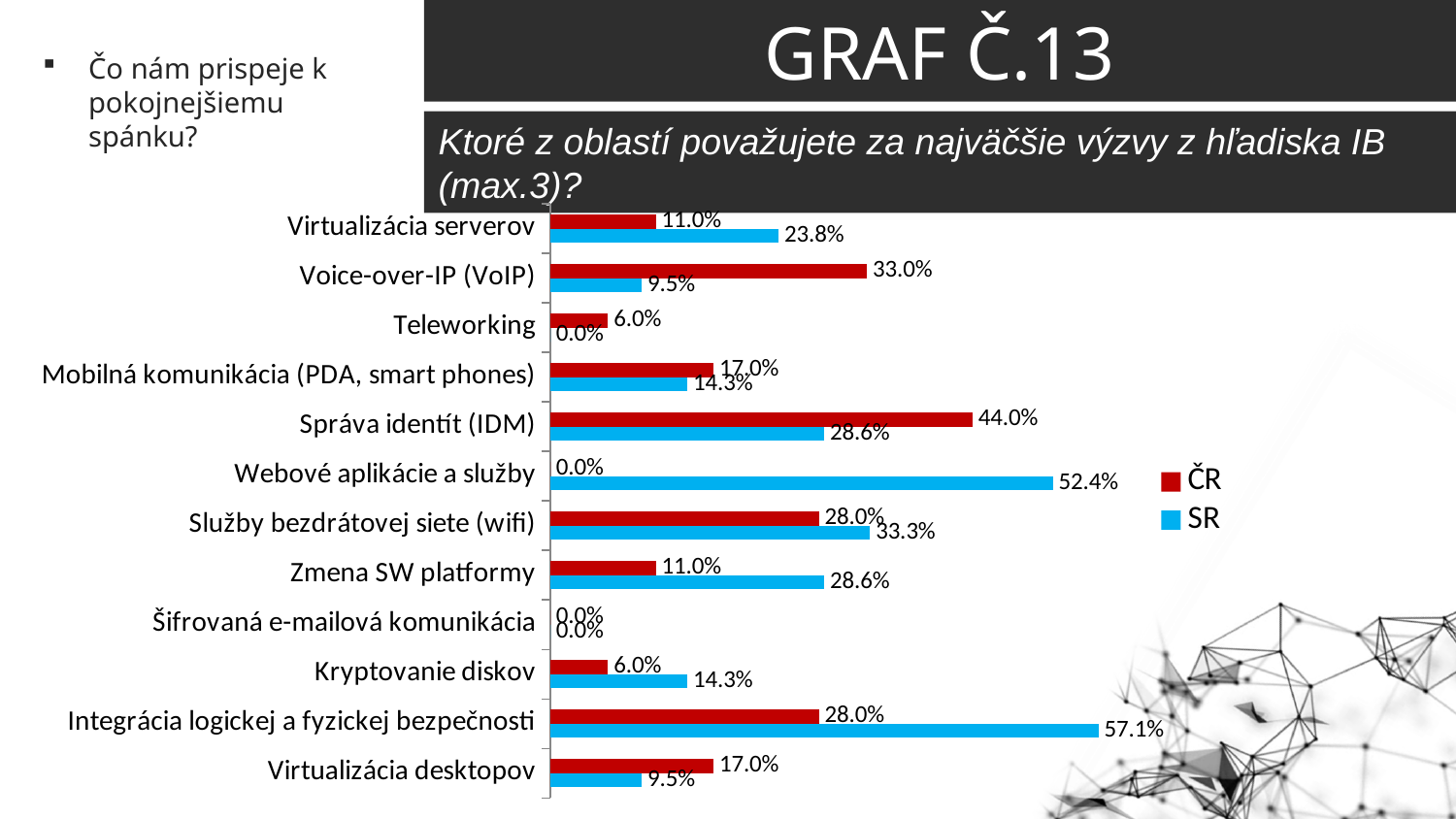
Which category has the highest ČR value? Správa identít (IDM) How many categories are plotted in the chart? 12 What is the difference between the SR and ČR values for Virtualizácia serverov? 12.8% What is the ČR value for Správa identít (IDM)? 44.0% What type of chart is shown on the slide? bar chart Which category has the highest SR value? Integrácia logickej a fyzickej bezpečnosti How many series does the legend list? 2 What is the SR value for Webové aplikácie a služby? 52.4% For Zmena SW platformy, which series has the larger value, ČR or SR? SR What is the ČR value for Voice-over-IP (VoIP)? 33.0% Which colour represents the SR series in the legend? blue What is the SR value for Integrácia logickej a fyzickej bezpečnosti? 57.1%